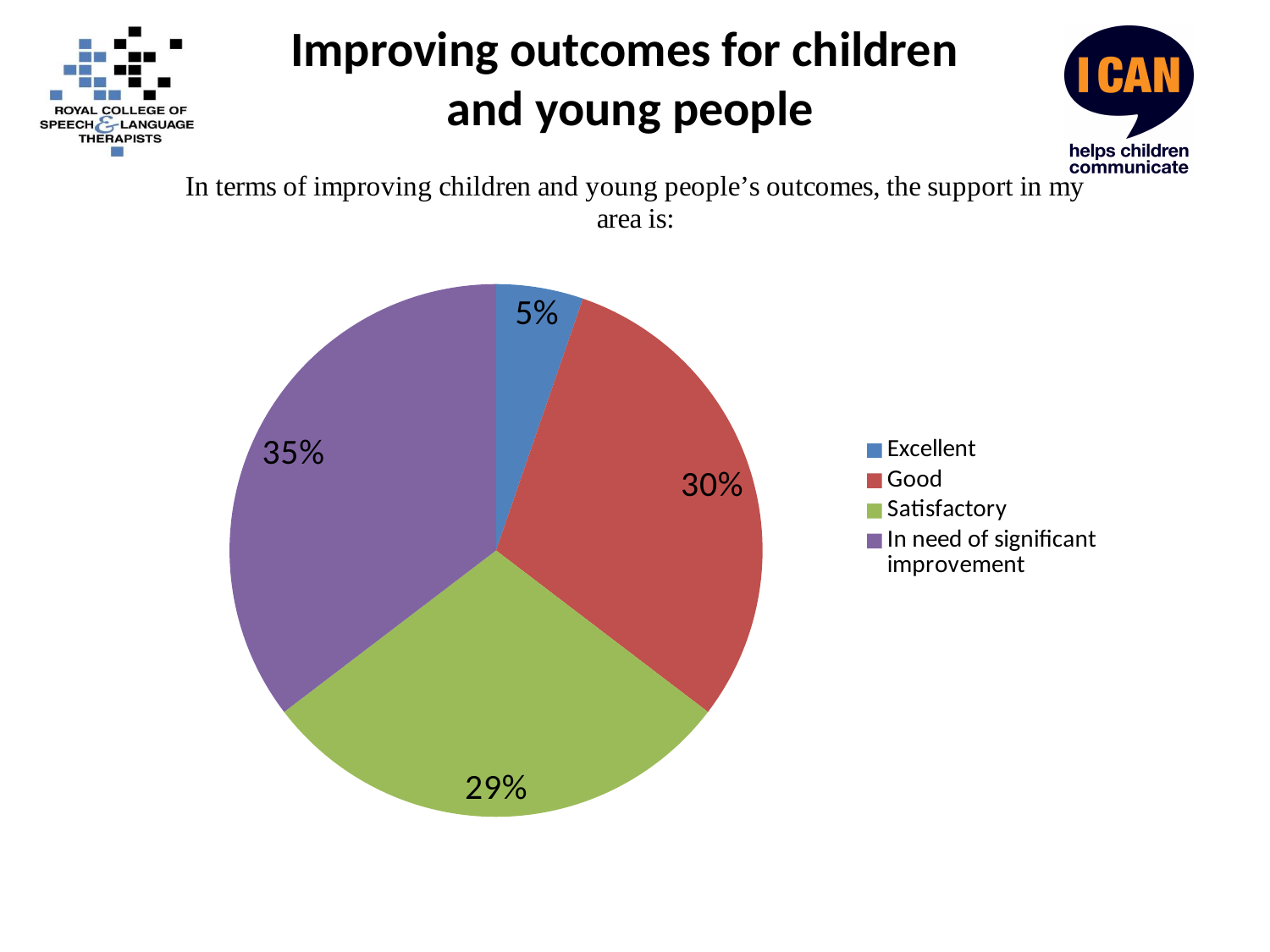
Which category has the smallest share of the pie? Excellent Which is larger, the Good slice or the Satisfactory slice? Good How many categories does the pie chart show? 4 What is the title of the chart? In terms of improving children and young people's outcomes, the support in my area is: What colour is the slice representing Satisfactory? Green What percentage of respondents said the support in their area is In need of significant improvement? 35% Which category has the largest share of the pie? In need of significant improvement What percentage of respondents rated the support in their area as Excellent? 5% What percentage of respondents rated the support in their area as Satisfactory? 29% What is the difference in percentage points between the In need of significant improvement slice and the Excellent slice? 30 What kind of chart is shown on the slide? Pie chart What percentage of respondents rated the support in their area as Good? 30%